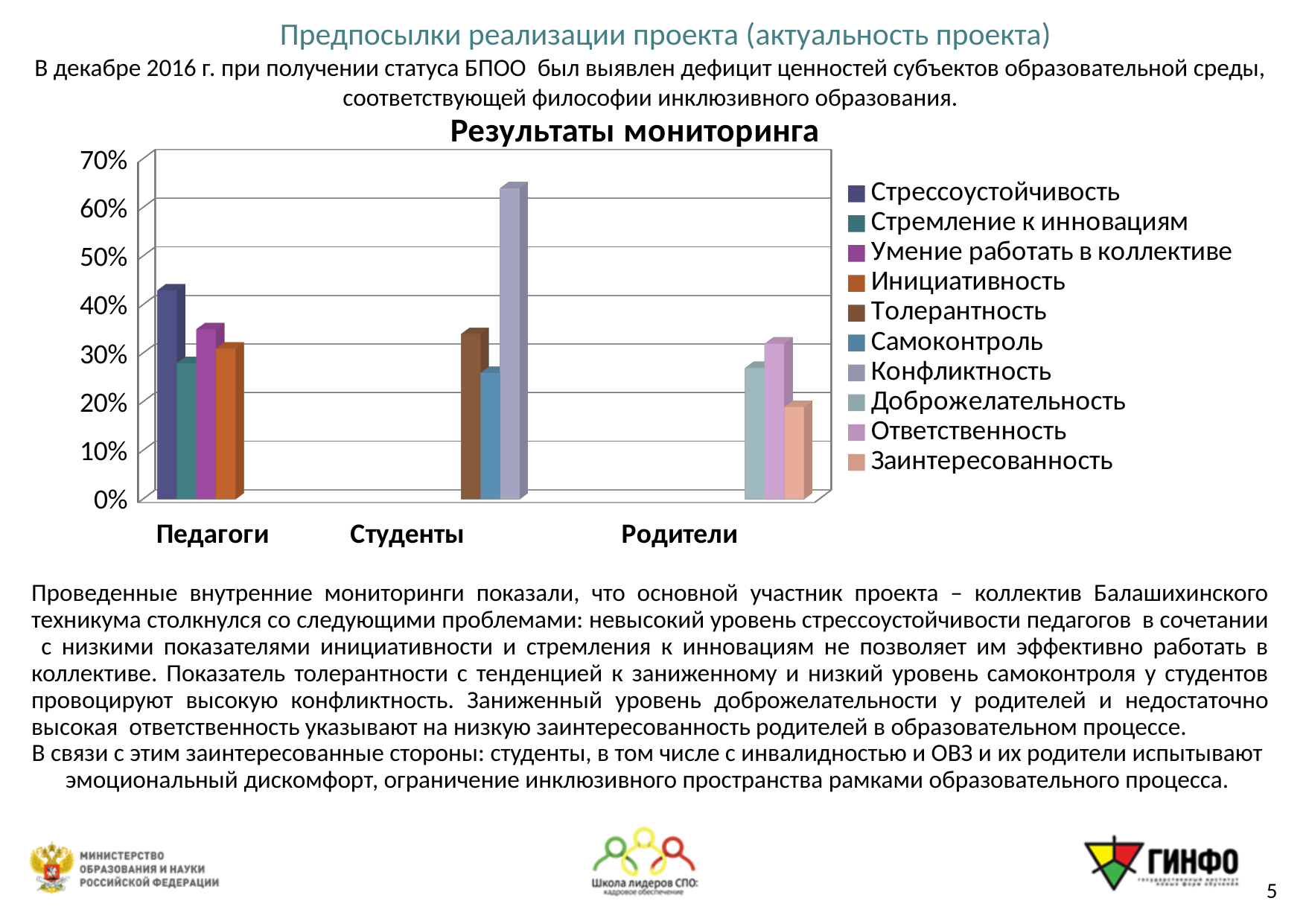
Is the value for Самоконтроль (Студенты) greater or less than 30%? less Which series has the shortest bar in the chart? Заинтересованность How many series does the chart legend list? 10 Which is larger: the bar for Стрессоустойчивость (Педагоги) or the bar for Конфликтность (Студенты)? Конфликтность How many categories are shown on the x axis of the chart? 3 What kind of chart is shown on the slide? bar chart Which category on the x axis contains the bar for Доброжелательность? Родители Is the value for Стрессоустойчивость (Педагоги) greater or less than 30%? greater Is the value for Конфликтность (Студенты) greater or less than 60%? greater What is the title of the chart? Результаты мониторинга Which series has the tallest bar in the chart? Конфликтность